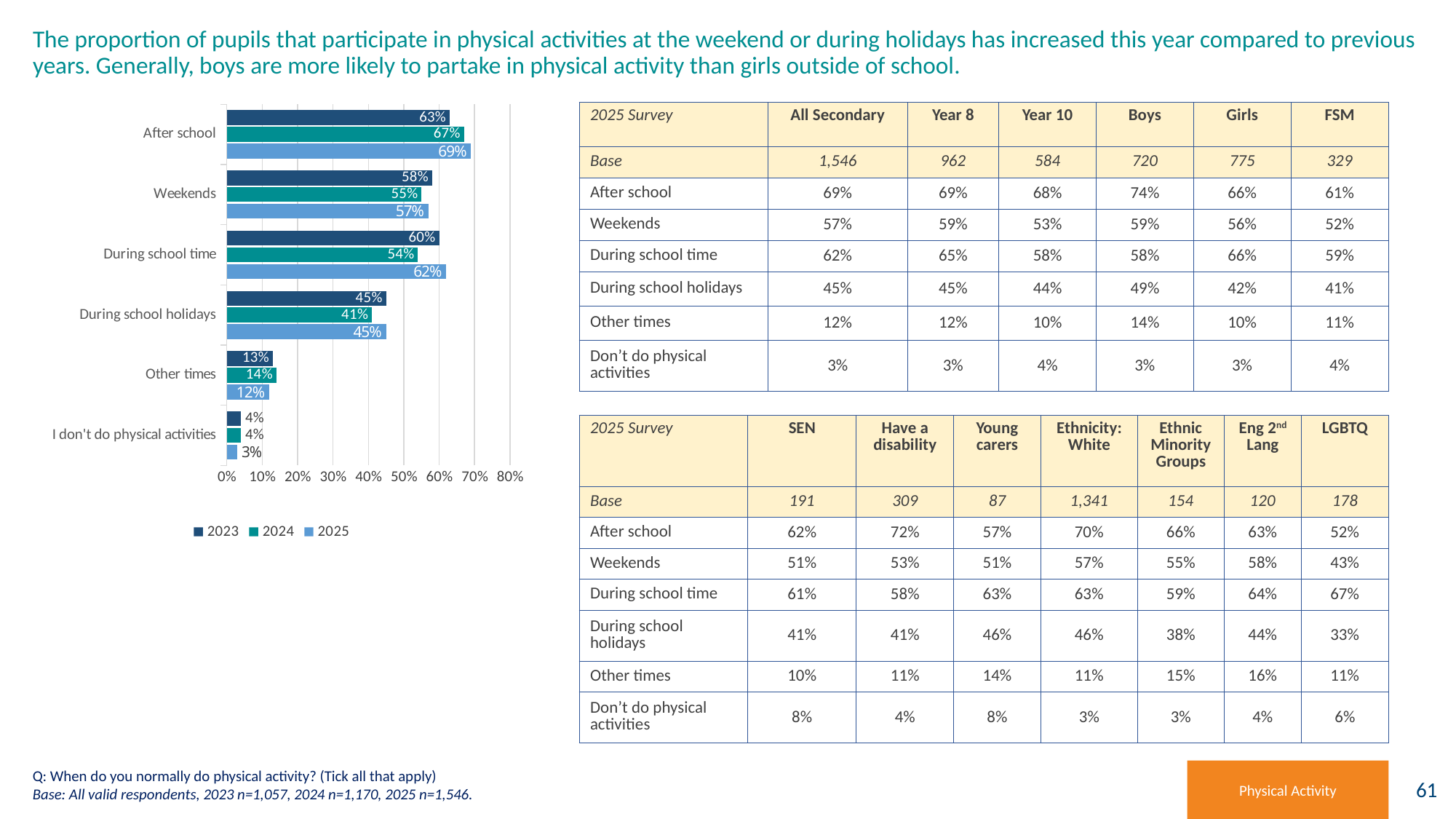
How many series does the legend of the bar chart list? 3 Which category has the highest 2025 value in the bar chart? After school In the bar chart, is the 2023 value for Weekends larger or the 2024 value for Weekends? 2023 What is the difference between the 2025 and 2024 values for During school time in the bar chart? 8% What is the 2025 value for After school in the bar chart? 69% What kind of chart is shown on the slide? Bar chart What is the difference between the 2025 and 2023 values for After school in the bar chart? 6% How many categories are shown in the bar chart? 6 What is the 2024 value for During school holidays in the bar chart? 41% What are the series names listed in the legend of the bar chart? 2023, 2024, 2025 Which category has the lowest 2023 value in the bar chart? I don't do physical activities What is the 2023 value for Other times in the bar chart? 13%